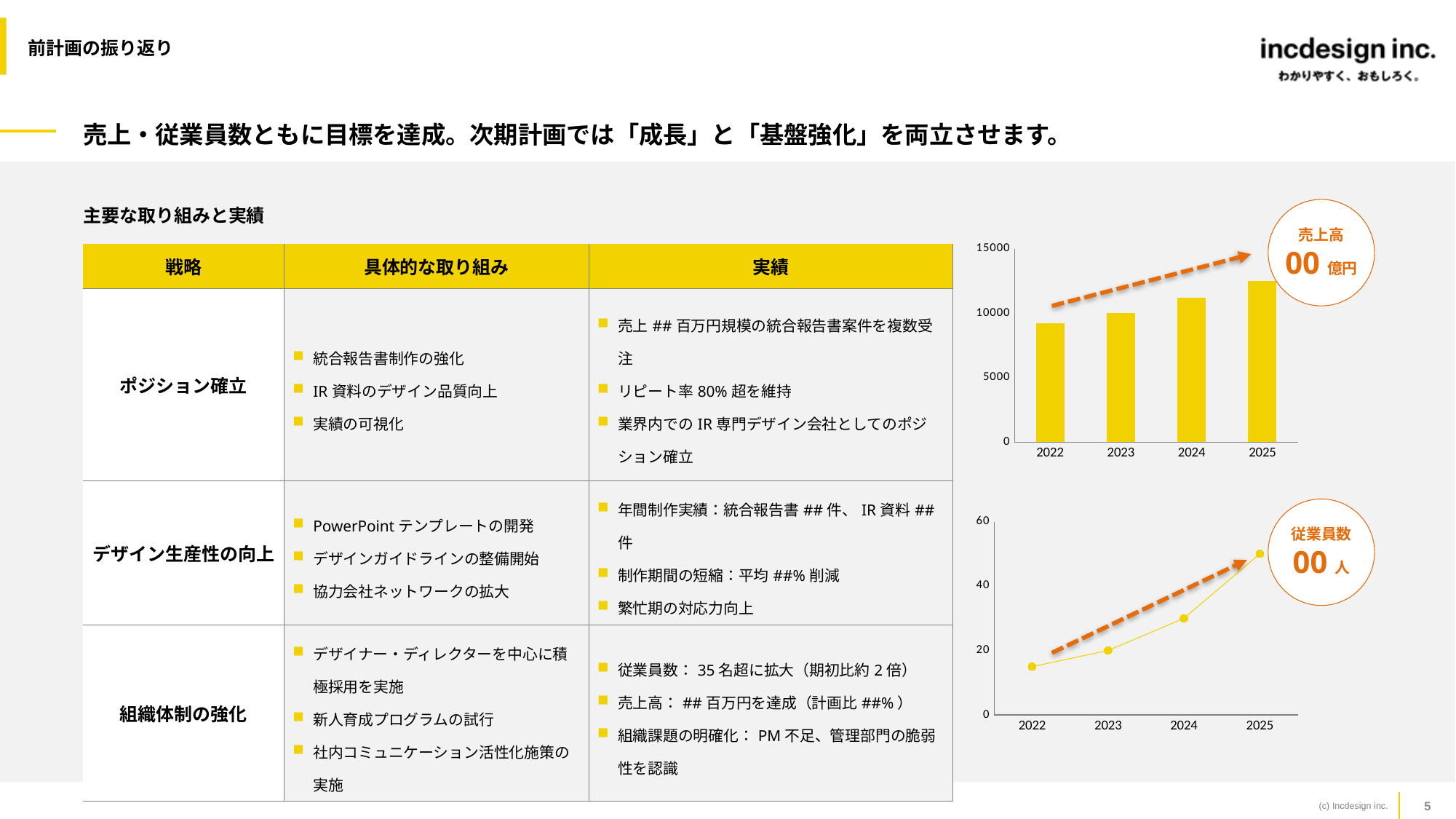
What kind of chart is the top chart on the right side of the slide? bar chart In the top bar chart, how many years are shown on the x axis? 4 In the top bar chart, is the value for 2025 greater or less than 10000? greater In the bottom line chart, which is larger, the value for 2023 or the value for 2024? 2024 In the top bar chart, is the value for 2022 greater or less than 10000? less What kind of chart is the bottom chart on the right side of the slide? line chart In the bottom line chart, is the value for 2022 greater or less than 20? less In the top bar chart, do the values rise or fall from 2022 to 2025? rise In the top bar chart, which year has the lowest bar? 2022 In the bottom line chart, which year has the highest point? 2025 In the top bar chart, which year has the highest bar? 2025